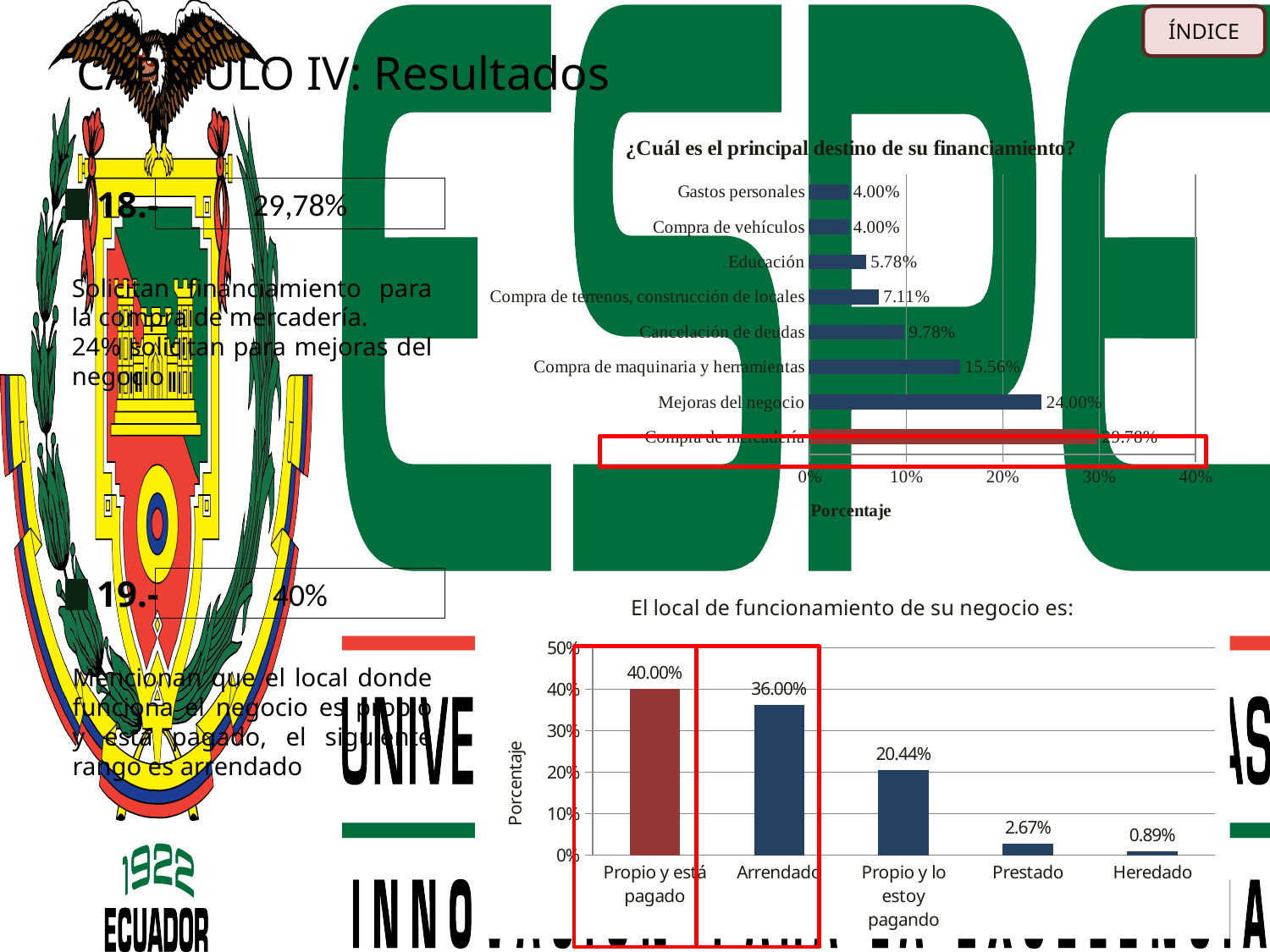
In the chart '¿Cuál es el principal destino de su financiamiento?', what is the value for Mejoras del negocio? 24.00% In the chart '¿Cuál es el principal destino de su financiamiento?', how many categories are listed? 8 In the chart '¿Cuál es el principal destino de su financiamiento?', what is the value for Compra de maquinaria y herramientas? 15.56% In the chart 'El local de funcionamiento de su negocio es:', what is the value for Arrendado? 36.00% In the chart 'El local de funcionamiento de su negocio es:', how many categories are shown on the x axis? 5 In the chart 'El local de funcionamiento de su negocio es:', what is the difference between Propio y está pagado and Arrendado? 4.00% In the chart '¿Cuál es el principal destino de su financiamiento?', what is the difference between Cancelación de deudas and Compra de terrenos, construcción de locales? 2.67% In the chart 'El local de funcionamiento de su negocio es:', which category has the highest value? Propio y está pagado In the chart 'El local de funcionamiento de su negocio es:', what is the value for Propio y lo estoy pagando? 20.44% In the chart 'El local de funcionamiento de su negocio es:', which category has the lowest value? Heredado In the chart '¿Cuál es el principal destino de su financiamiento?', which is larger: Cancelación de deudas or Educación? Cancelación de deudas What type of chart is 'El local de funcionamiento de su negocio es:'? Bar chart